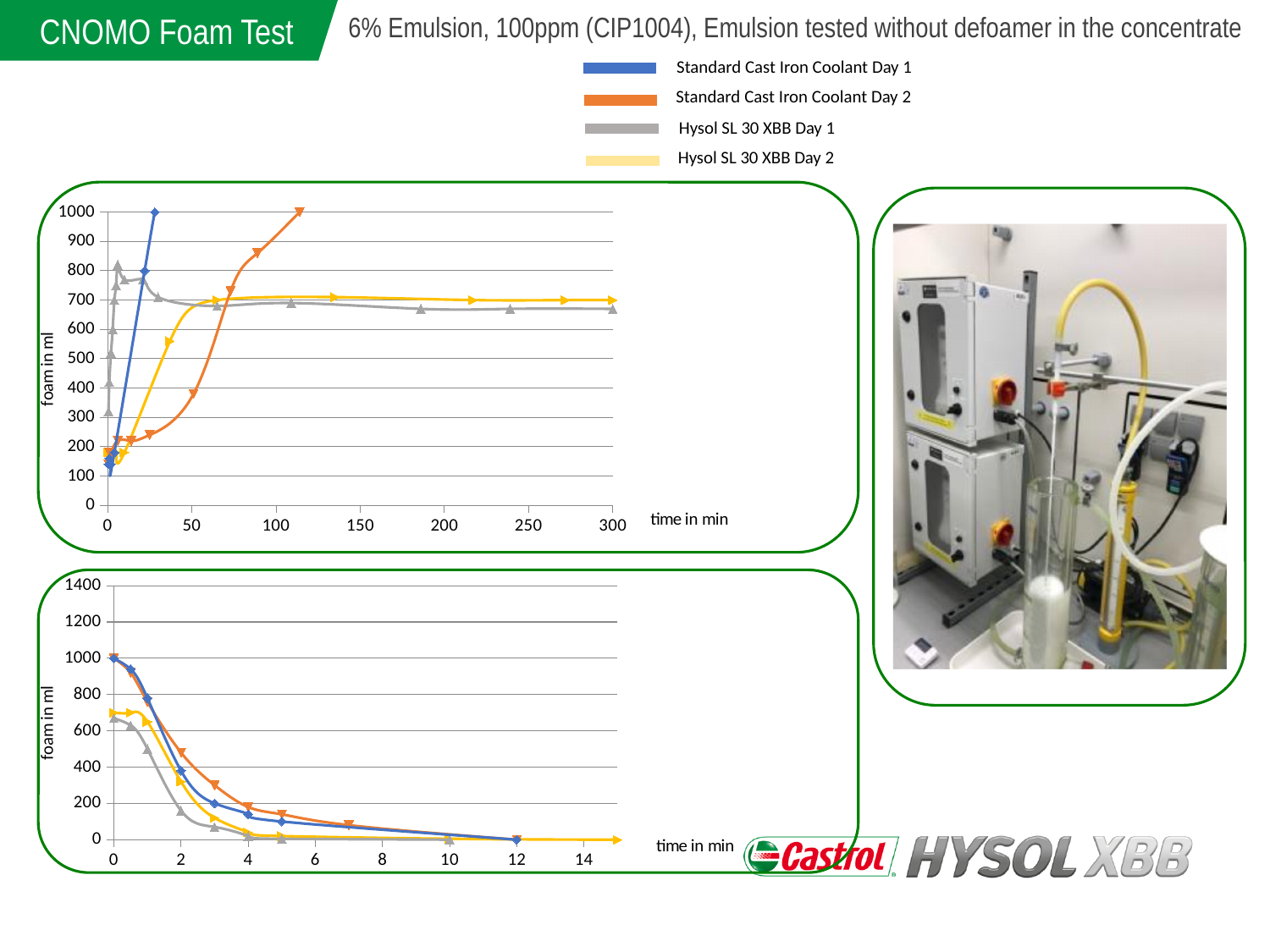
In the lower chart, do the values rise or fall as time increases? fall In the lower chart, is the value for Hysol SL 30 XBB Day 1 at 2 min greater or less than 400? less What kind of chart is the upper chart on the slide? line chart In the upper chart, which series reaches 1000 ml first, Standard Cast Iron Coolant Day 1 or Standard Cast Iron Coolant Day 2? Standard Cast Iron Coolant Day 1 What is the x-axis label of the lower chart? time in min What kind of chart is the lower chart on the slide? line chart In the lower chart, at 0 min, which is larger: Standard Cast Iron Coolant Day 1 or Hysol SL 30 XBB Day 2? Standard Cast Iron Coolant Day 1 What is the y-axis label of the upper chart? foam in ml In the upper chart, is the value for Standard Cast Iron Coolant Day 1 at 0 min greater or less than 300? less How many series does the legend list for the charts? 4 In the upper chart, is the value for Hysol SL 30 XBB Day 1 at 300 min greater or less than 500? greater